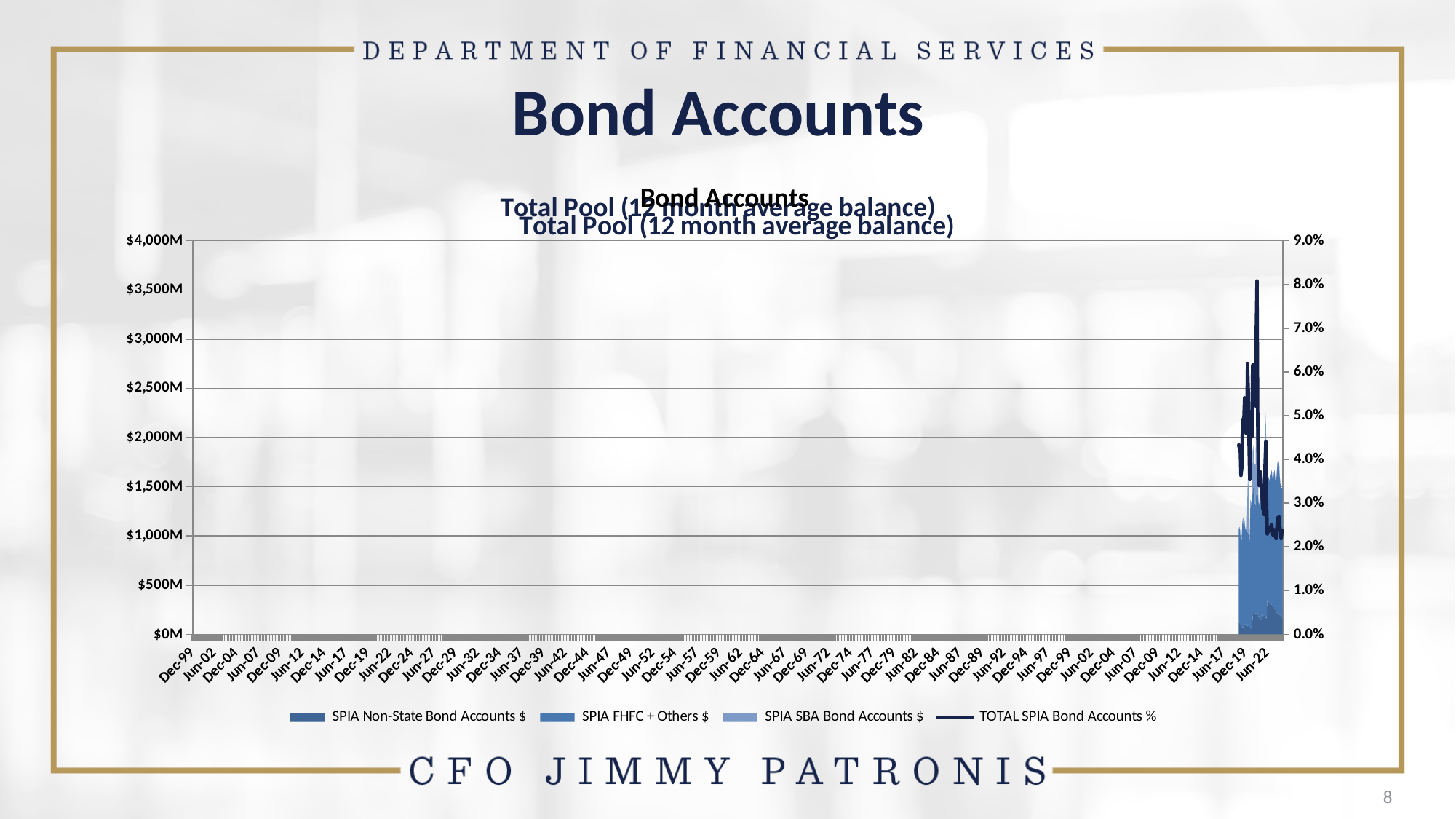
Which series is drawn as a line rather than as stacked bars? TOTAL SPIA Bond Accounts % How many series does the legend list? 4 Is the total stacked balance at Dec-99 greater or less than $500M? less Is the peak value of the TOTAL SPIA Bond Accounts % line greater or less than 7.0%? greater What is the first label on the x axis? Dec-99 Does the TOTAL SPIA Bond Accounts % line rise or fall from its peak to Jun-22? fall What is the highest value shown on the left vertical axis? $4,000M What kind of chart is shown on the slide? a stacked area chart with a line What is the highest value shown on the right vertical axis? 9.0% Is the total stacked balance at Jun-22 greater or less than $2,000M? less